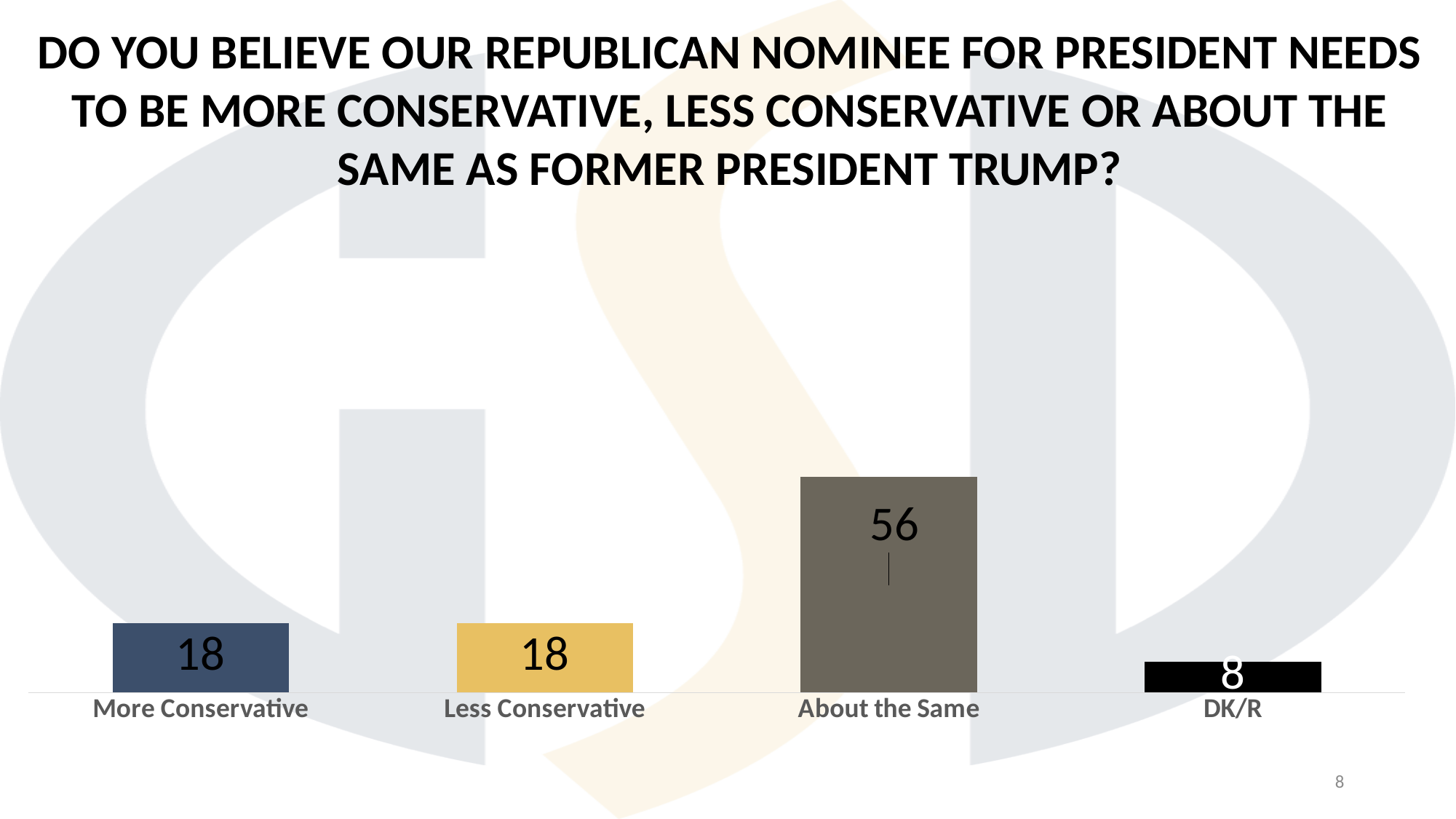
Which category has the highest value? About the Same How many categories are shown in the chart? 4 What is the value for Less Conservative? 18 What is the value for About the Same? 56 Which category has the lowest value? DK/R What is the value for More Conservative? 18 What is the value for DK/R? 8 What is the difference between the values for Less Conservative and DK/R? 10 Which is larger, the value for About the Same or the value for DK/R? About the Same What kind of chart is shown on the slide? Bar chart What is the difference between the values for About the Same and More Conservative? 38 What colour is the bar for Less Conservative? Yellow